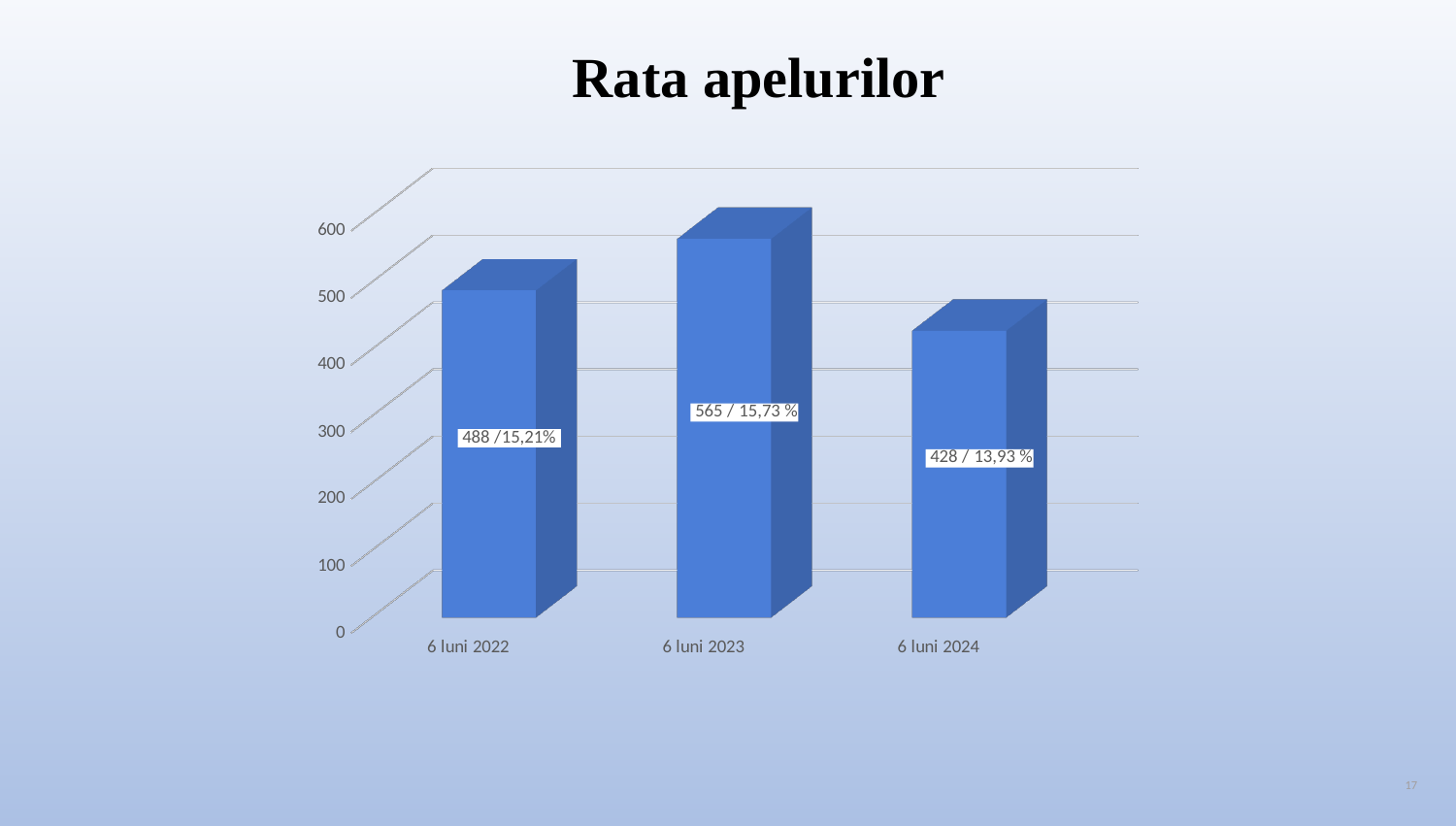
What is the difference between the count for 6 luni 2022 (488) and the count for 6 luni 2024 (428)? 60 What kind of chart is shown on the slide? bar chart How many categories are shown on the x axis? 3 Which is larger, the value for 6 luni 2022 or the value for 6 luni 2024? 6 luni 2022 What is the data label shown on the bar for 6 luni 2023? 565 / 15,73 % What is the data label shown on the bar for 6 luni 2022? 488 /15,21% Which category has the highest bar? 6 luni 2023 Which category has the lowest bar? 6 luni 2024 What is the difference between the count for 6 luni 2023 (565) and the count for 6 luni 2022 (488)? 77 What is the data label shown on the bar for 6 luni 2024? 428 / 13,93 % Is the value for 6 luni 2024 greater or less than 500? less What is the title of the chart? Rata apelurilor